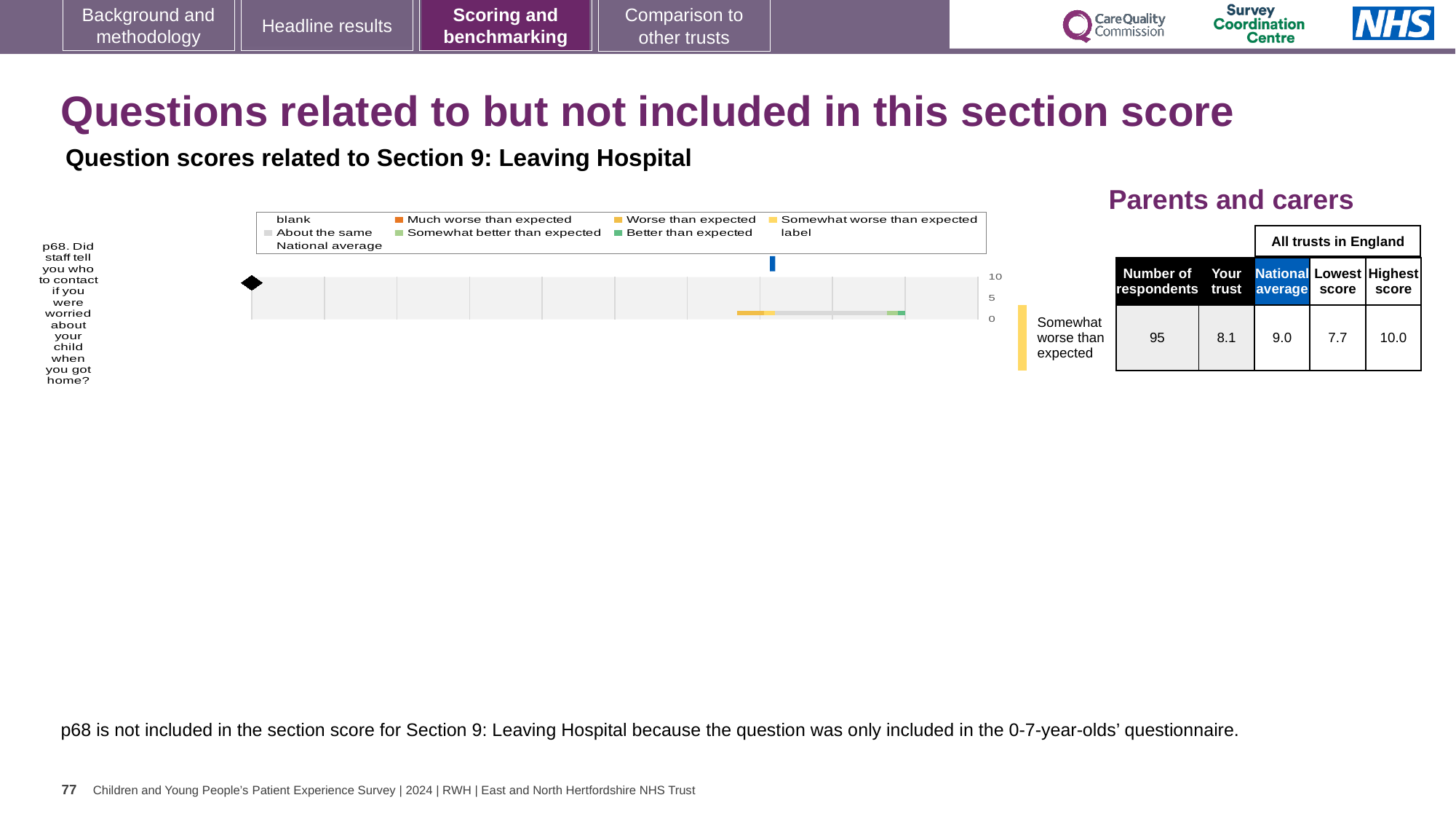
Is the 'Your trust' score for p68 greater or less than 5 on the chart axis? greater What is the difference between the national average and the 'Your trust' score for p68? 0.9 Which is larger for p68, the 'Your trust' score or the national average? National average What is the highest score among all trusts in England for p68? 10.0 What is the lowest score among all trusts in England for p68? 7.7 What is the 'Your trust' score for p68? 8.1 What is the national average score for p68? 9.0 What kind of chart is used to show the p68 question score? bar chart How many respondents answered p68? 95 Which question number is plotted in the chart? p68 How many questions are plotted in the chart? 1 What benchmark rating is given to the trust for p68? Somewhat worse than expected